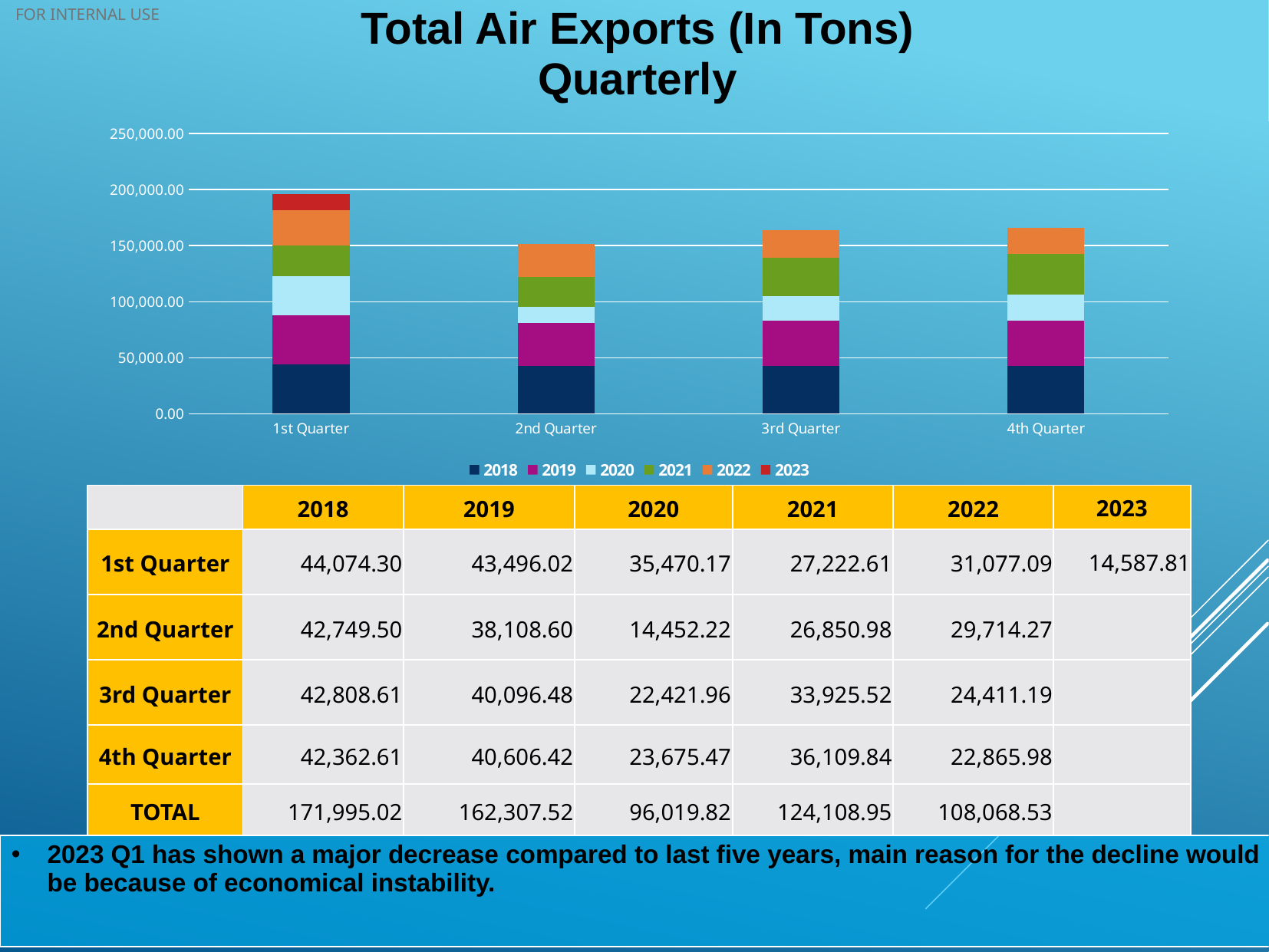
What kind of chart is shown on the slide? Stacked bar chart How many quarters are plotted along the x axis of the chart? 4 Is the total height of the 1st Quarter stacked bar greater or less than 150,000.00? greater What is the total of the 1st Quarter stacked bar across all years? 195,928.00 What is the 2nd Quarter value for 2020? 14,452.22 Do the 2022 values rise or fall from the 1st Quarter to the 4th Quarter? fall What is the 1st Quarter value for 2023? 14,587.81 Which quarter has the tallest stacked bar? 1st Quarter How many series does the chart legend list? 6 What is the difference between the 2018 and 2019 values for the 1st Quarter? 578.28 Which quarter has the shortest stacked bar? 2nd Quarter Which is larger for the 3rd Quarter, the 2021 value or the 2022 value? 2021